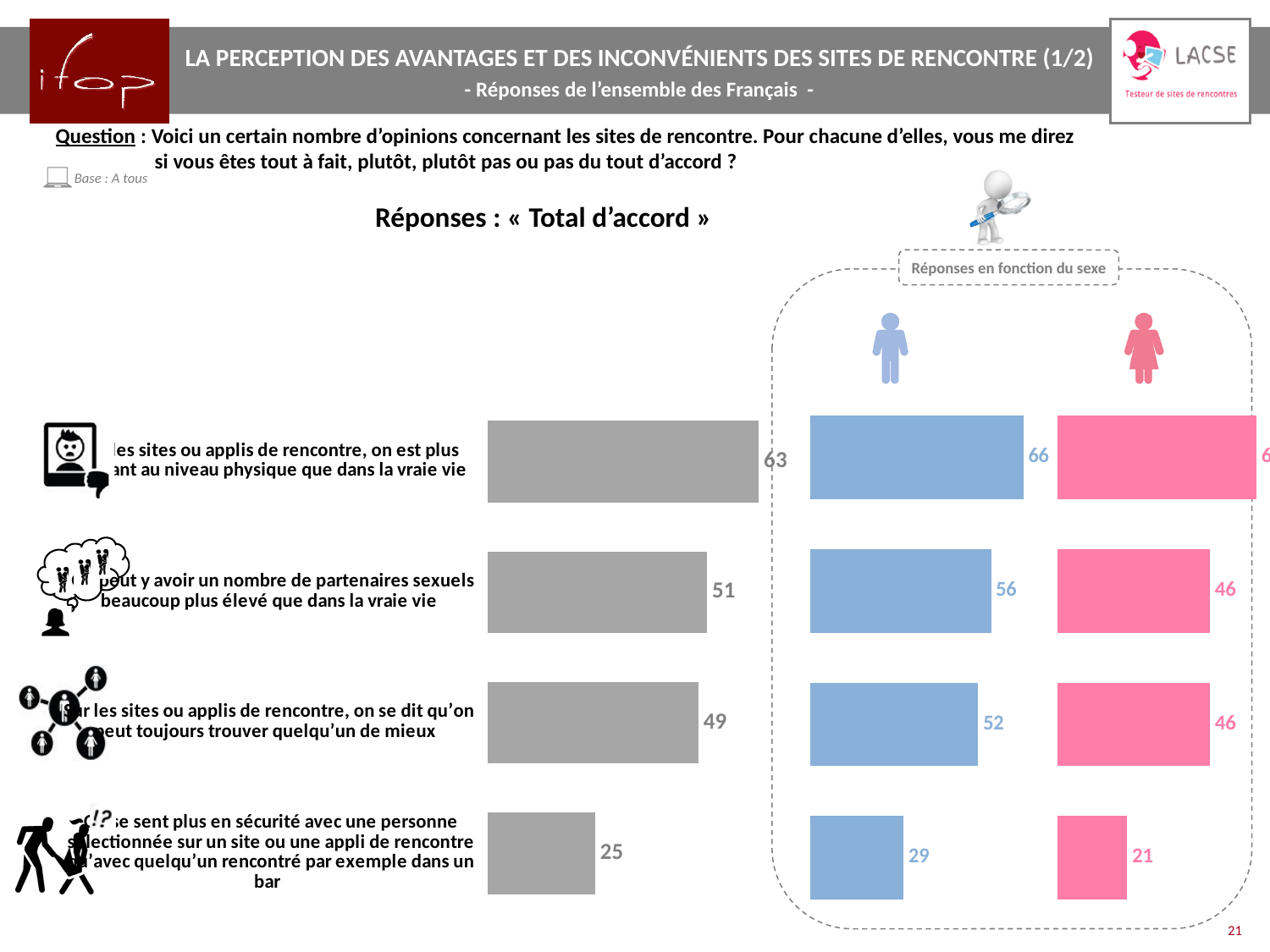
What is the difference between the men's value (56) and the women's value (46) for the statement about a much higher number of sexual partners? 10 What type of chart is used to show the « Total d'accord » responses? Bar chart In the blue men's chart, which statement has the highest value? The first statement, about being more demanding on physical appearance than in real life (66) In the grey overall chart (Réponses : « Total d'accord »), what is the value for the statement about always being able to find someone better ("on se dit qu'on peut toujours trouver quelqu'un de mieux")? 49 Which colour represents women's responses in the « Réponses en fonction du sexe » section? Pink What is the difference between the overall value (63) and the men's value (66) for the first statement, about being more demanding on physical appearance? 3 In the grey overall chart, which statement has the lowest value? Feeling safer with a person selected on a dating site than with someone met in a bar (25) In the pink women's chart, what is the value for the statement about feeling safer with a person selected on a dating site than with someone met in a bar? 21 In the blue men's chart (Réponses en fonction du sexe), what is the value for the statement about having a much higher number of sexual partners than in real life? 56 For the statement about always being able to find someone better, which is larger: the men's value or the women's value? The men's value (52 vs 46) In the grey overall chart, what is the value for the statement about feeling safer with a person selected on a dating site than with someone met in a bar? 25 How many statements (categories) are plotted in the grey overall chart? 4